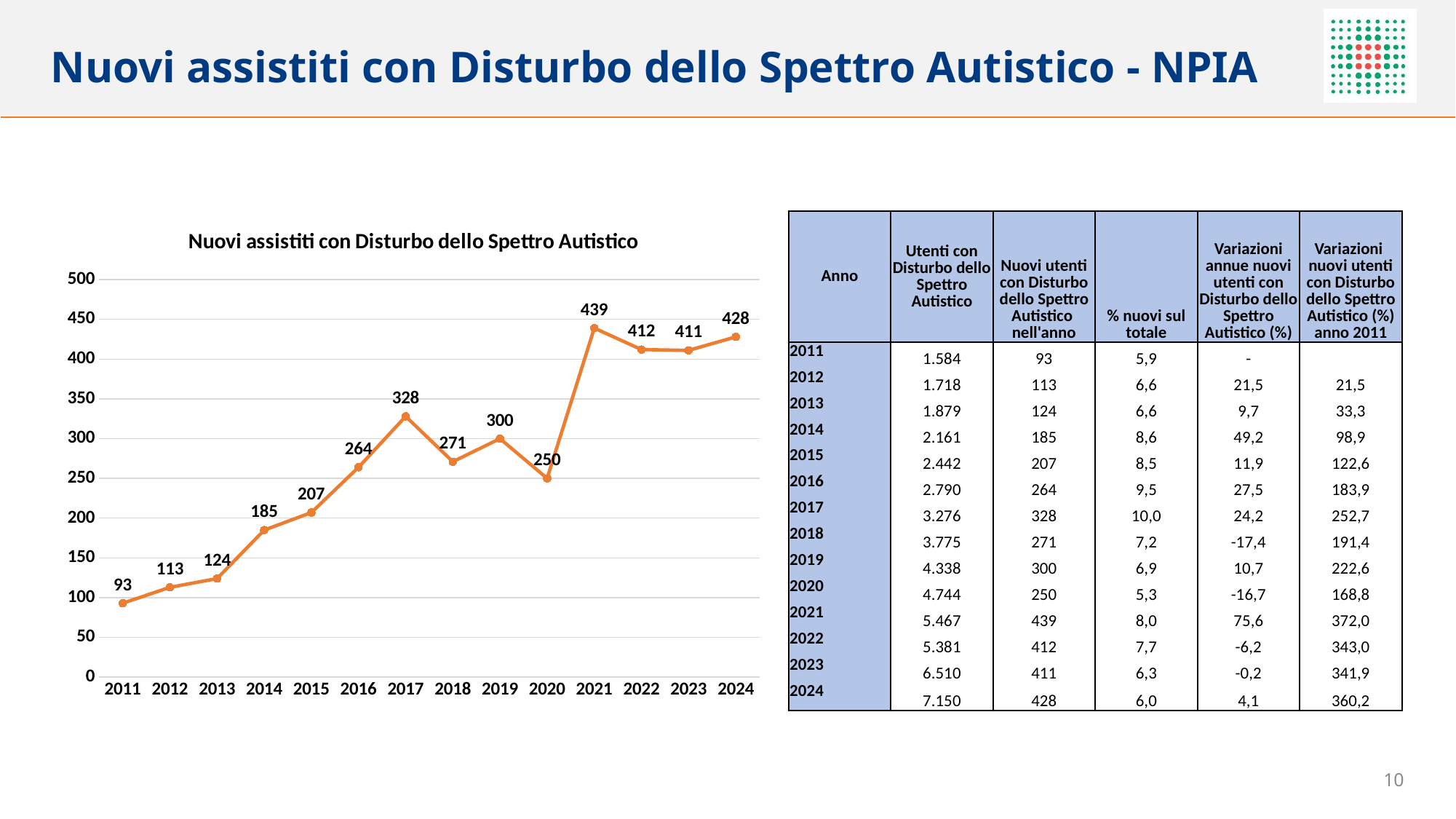
Which year has the lowest value in the chart? 2011 How many years are plotted on the x axis of the chart? 14 What is the title of the chart? Nuovi assistiti con Disturbo dello Spettro Autistico Which year has the highest value in the chart? 2021 Do the values generally rise or fall from 2011 to 2024? rise What is the difference between the values for 2024 and 2011? 335 What is the value for 2017 in the chart? 328 Which is larger, the value for 2018 or the value for 2019? 2019 What is the difference between the values for 2021 and 2020? 189 What kind of chart is shown on the slide? line chart What is the value for 2020 in the chart? 250 Is the value for 2016 greater or less than 250? greater